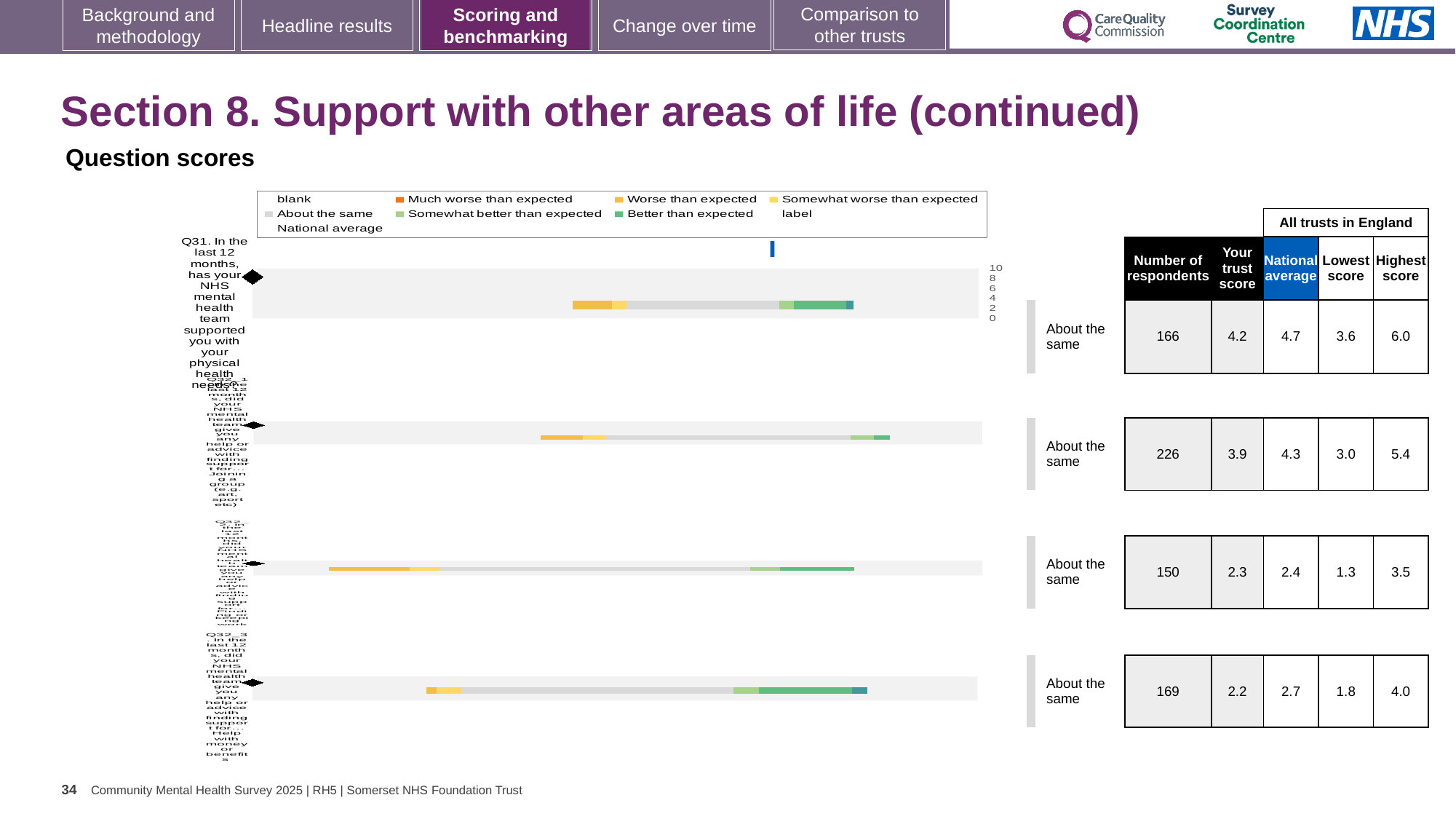
How many question bars are plotted in the chart? 4 What is the highest score among all trusts in England shown for Q31 (support with physical health needs)? 6.0 What is the national average shown for Q31 (support with physical health needs)? 4.7 Which is larger for Q31 (support with physical health needs): the trust score or the national average? national average What is the highest value shown on the chart's numeric axis? 10 Which of the four questions has the lowest trust score? Q32_3 (help with money or benefits) What benchmark category is shown for each of the four questions on the slide? About the same What is the number of respondents shown for Q31 (support with physical health needs)? 166 What kind of chart is shown on the slide? bar chart What is the trust score shown for Q31 (support with physical health needs)? 4.2 Which legend entry is shown in grey in the chart? About the same What is the difference between the national average and the trust score for Q31 (support with physical health needs)? 0.5